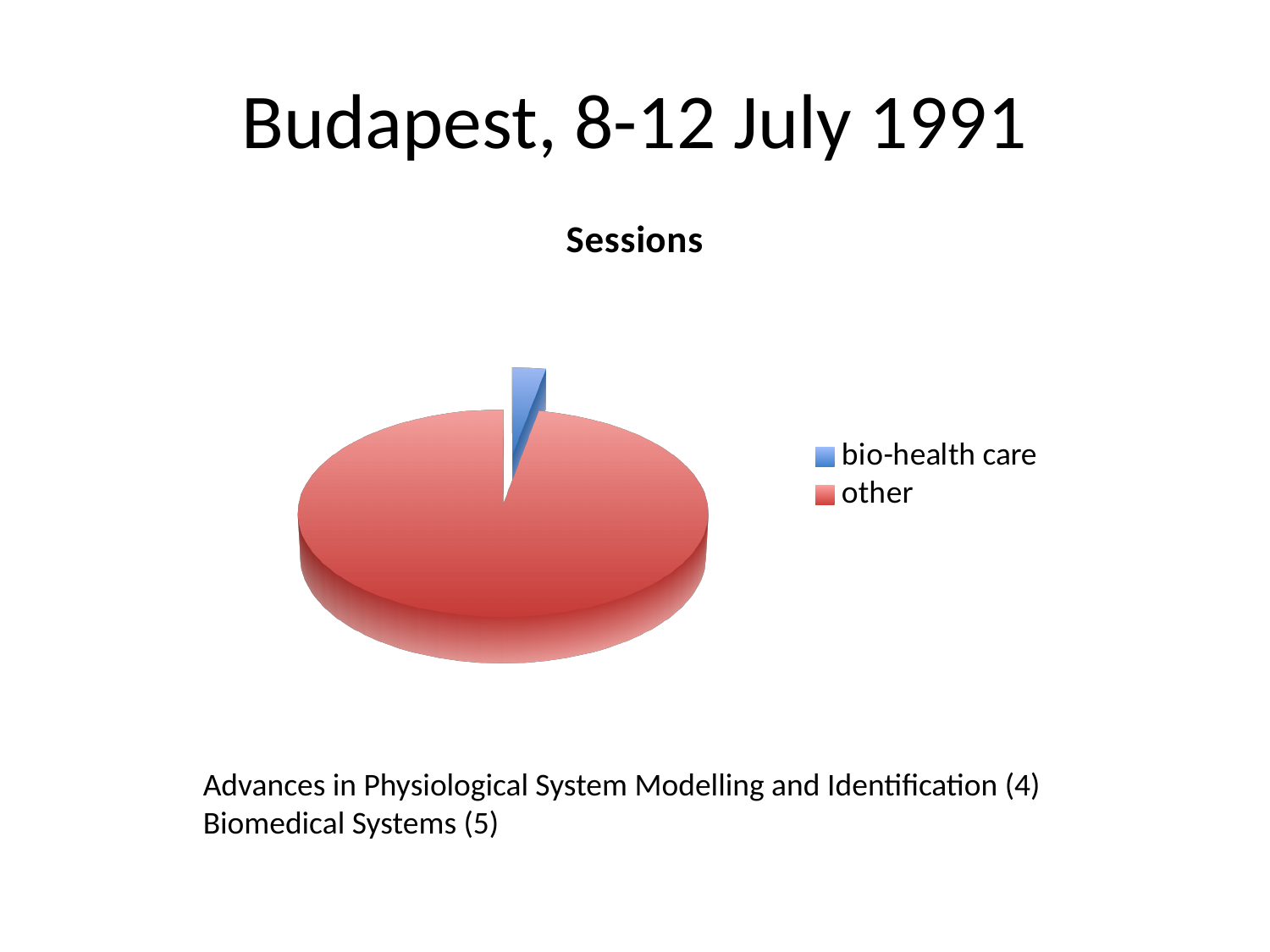
Which slice of the pie is the largest? other Which slice of the pie is the smallest? bio-health care How many series does the legend list? 2 What colour is the bio-health care slice? blue What is the title of the chart? Sessions How many slices does the pie chart have? 2 Which slice is larger, bio-health care or other? other What kind of chart is shown on the slide? pie chart